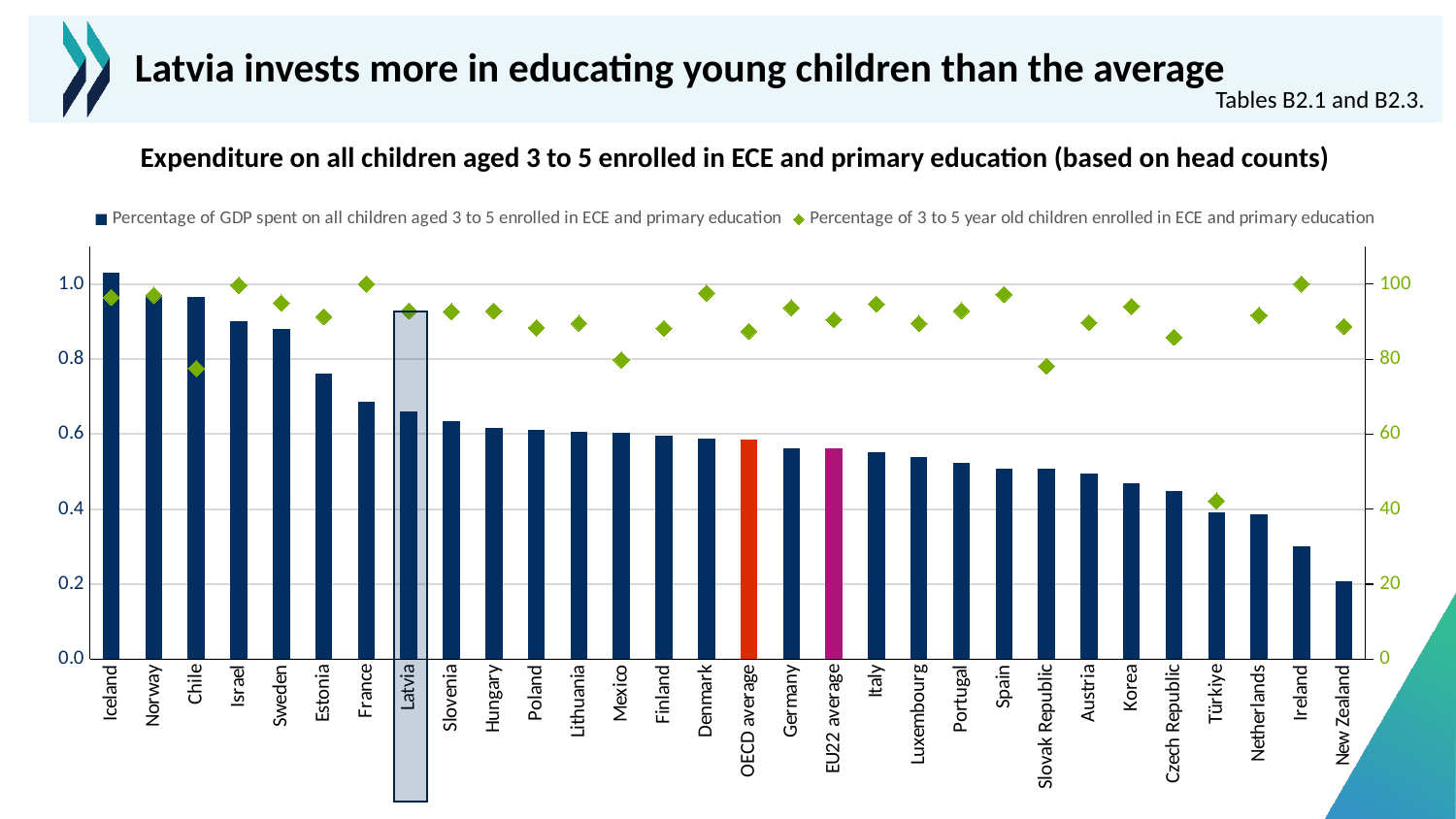
Is the percentage of 3 to 5 year old children enrolled in ECE and primary education for Türkiye greater or less than 60? less Which country has the lowest percentage of GDP spent on all children aged 3 to 5 enrolled in ECE and primary education? New Zealand Which country has the highest percentage of GDP spent on all children aged 3 to 5 enrolled in ECE and primary education? Iceland How many countries or averages are shown on the x axis? 30 Which has a higher percentage of GDP spent on children aged 3 to 5: Estonia or France? Estonia Which country has the lowest percentage of 3 to 5 year old children enrolled in ECE and primary education? Türkiye Is the percentage of GDP spent on children aged 3 to 5 for Latvia greater or less than 0.6? greater Which has a higher percentage of GDP spent on children aged 3 to 5: Latvia or the OECD average? Latvia How many series does the legend list? 2 Is the percentage of GDP spent on children aged 3 to 5 for Ireland greater or less than 0.4? less Do the bars for percentage of GDP spent rise or fall from left to right across the x axis? fall